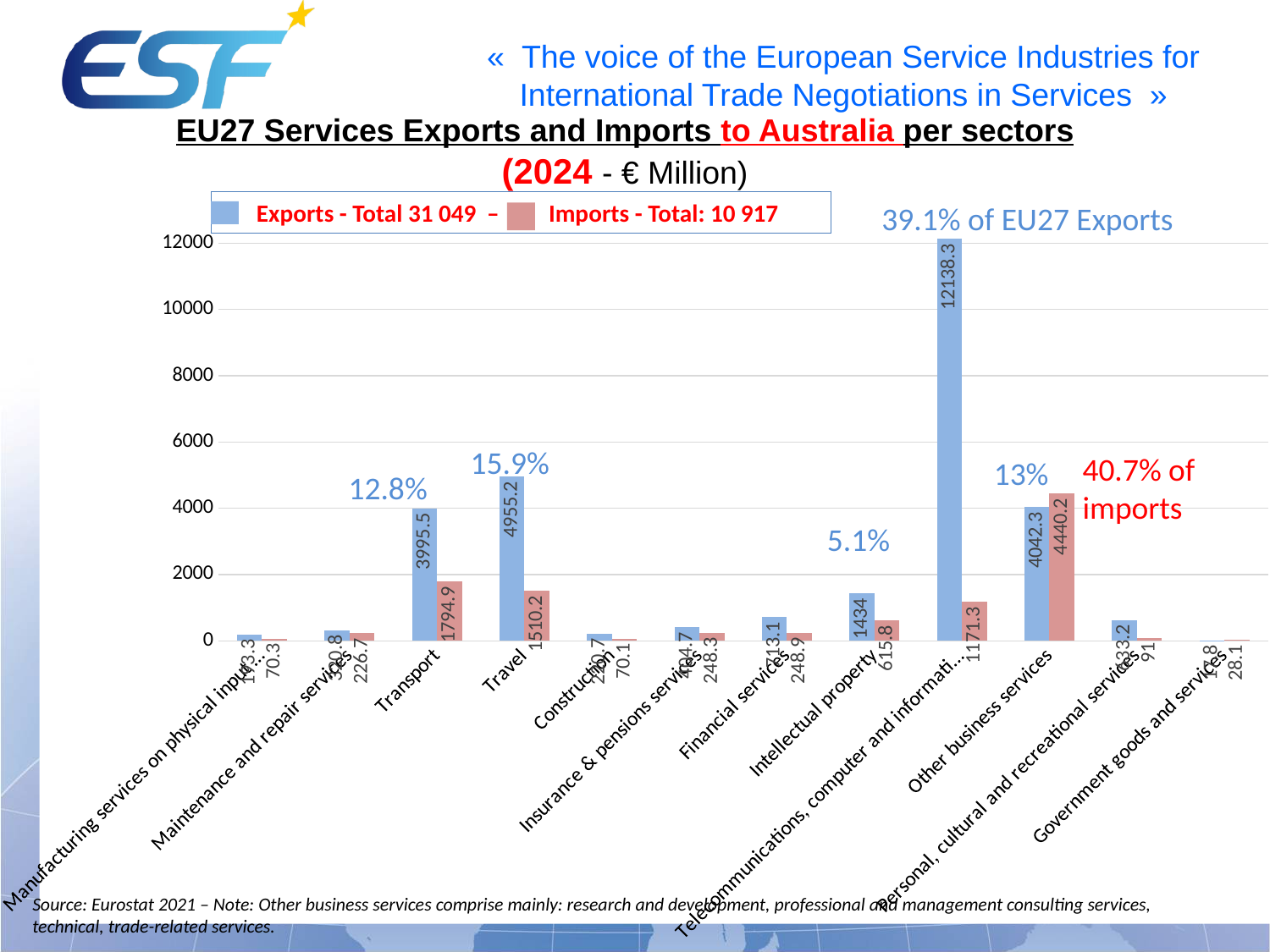
What is the difference between exports and imports for Transport? 2200.6 How many series does the legend list? 2 Which sector has the highest exports value? Telecommunications, computer and information services Which sector has the lowest imports value? Government goods and services What is the imports value for Other business services? 4440.2 What is the exports value for Telecommunications, computer and information services? 12138.3 Is the exports value for Telecommunications, computer and information services greater or less than 12000? greater What is the value of EU27 services exports to Australia for Transport? 3995.5 What is the value of imports for Travel? 1510.2 For Other business services, which is larger: exports or imports? Imports What total for Exports is stated in the legend? 31 049 How many sectors are shown on the x axis? 12